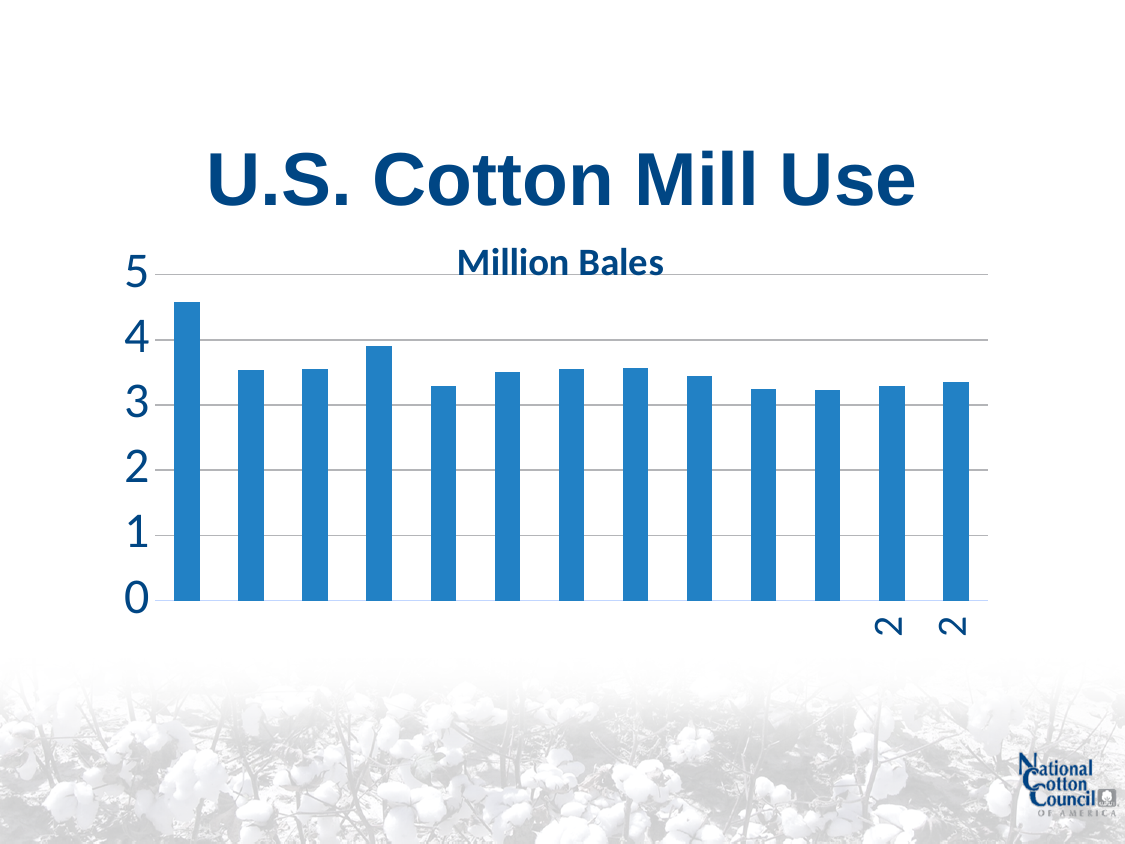
Is the value of the first bar from the left greater or less than 4? greater What kind of chart is shown on the slide? bar chart Which is larger, the first bar from the left or the second bar from the left? the first bar What is the title of the chart? U.S. Cotton Mill Use How many bars exceed 4 on the chart? 1 Is the value of the last bar on the right greater or less than 3? greater Is the value of the fifth bar from the left greater or less than 4? less In what unit are the values on the chart expressed? Million Bales Which bar is the highest on the chart? the first bar from the left Which is larger, the fourth bar from the left or the fifth bar from the left? the fourth bar How many bars are plotted on the chart? 13